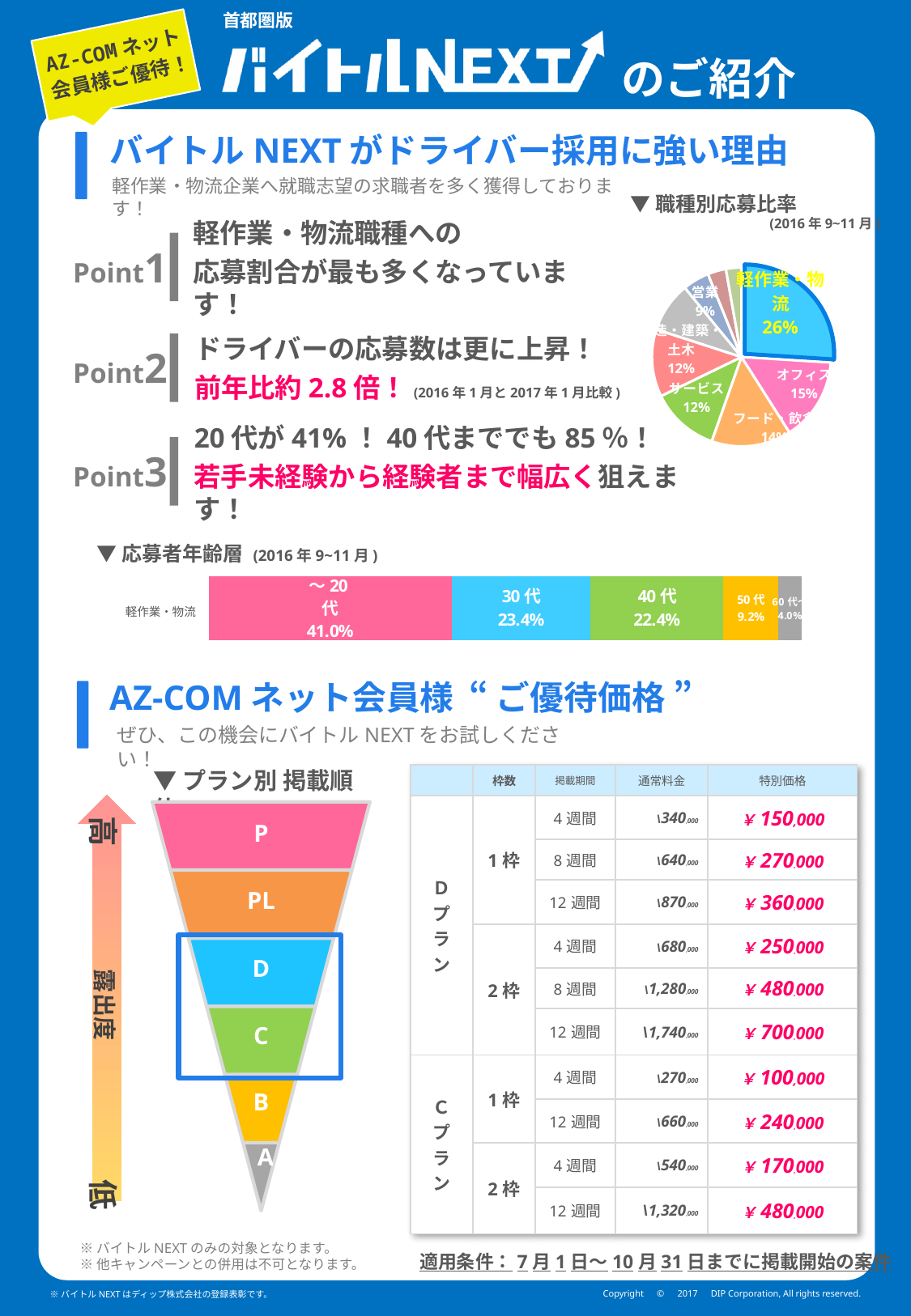
In the 職種別応募比率 pie chart, what is the share for 軽作業・物流? 26% How many age-group segments are shown in the 応募者年齢層 bar chart? 5 In the 応募者年齢層 bar chart, which age group has the smallest segment? 60代～ In the 応募者年齢層 bar chart, what is the difference between the ～20代 and 30代 values? 17.6% In the 応募者年齢層 bar chart, what is the value for 30代? 23.4% What kind of chart is the 職種別応募比率 chart? Pie chart In the 職種別応募比率 pie chart, which category has the largest slice? 軽作業・物流 In the 応募者年齢層 bar chart, what is the value for ～20代? 41.0% In the 職種別応募比率 pie chart, what is the difference between the shares of 軽作業・物流 and 営業? 17% In the 職種別応募比率 pie chart, which is larger, 軽作業・物流 or オフィス? 軽作業・物流 In the 職種別応募比率 pie chart, what is the share for オフィス? 15% In the 職種別応募比率 pie chart, what is the share for 営業? 9%